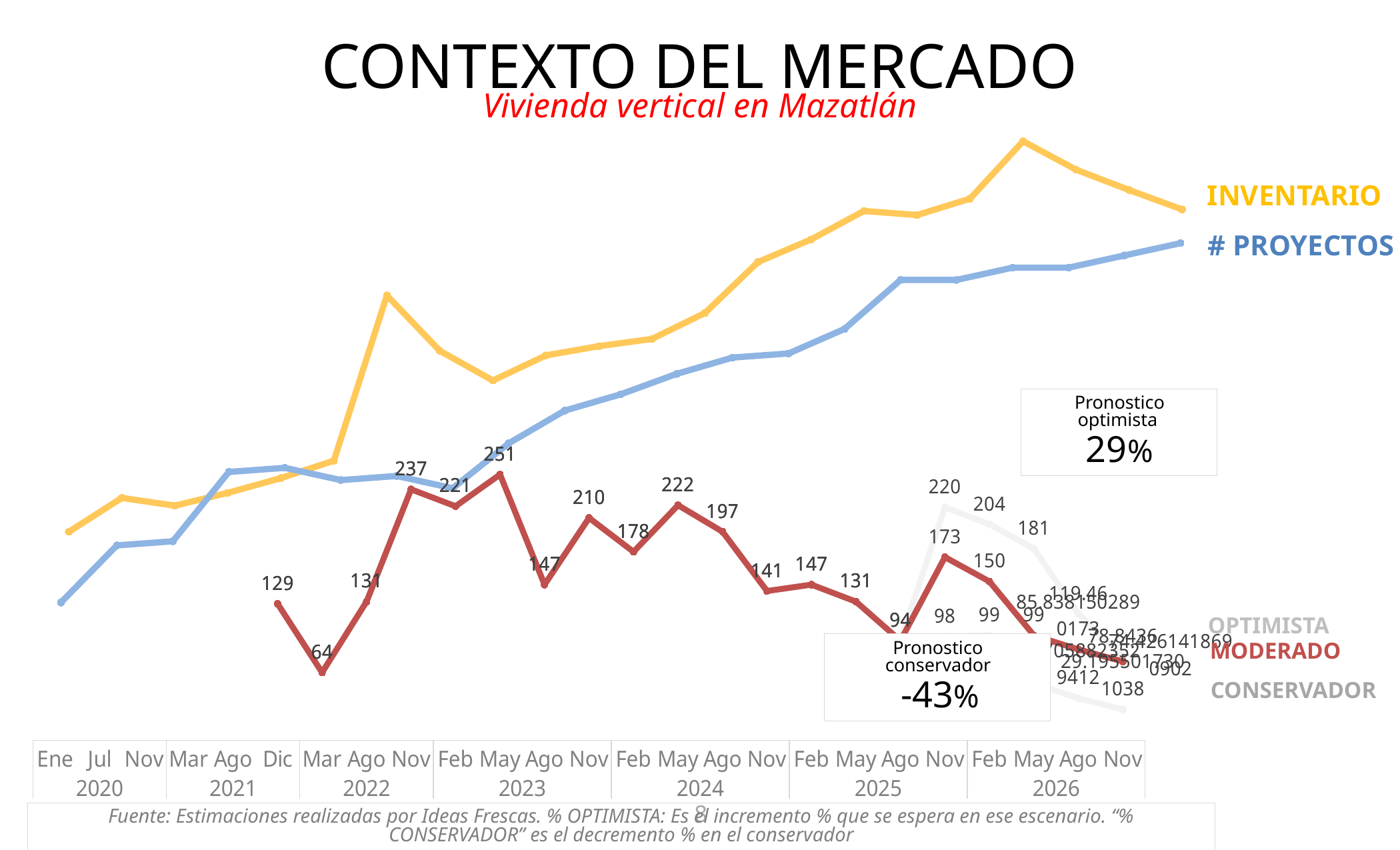
What is the difference between the highest labelled value (251) and the lowest labelled value (64) on the MODERADO line? 187 What kind of chart is shown on the slide? line chart What percentage is shown for the 'Pronostico conservador'? -43% At the right end of the chart (Nov 2026), which line is higher, INVENTARIO or # PROYECTOS? INVENTARIO What is the lowest labelled value on the MODERADO line? 64 Does the # PROYECTOS line generally rise or fall from 2020 to 2026? rise How many years are labelled along the x axis? 7 What is the difference between the MODERADO labelled values 237 and 221? 16 On the MODERADO line, which labelled value is larger, 222 or 210? 222 What percentage is shown for the 'Pronostico optimista'? 29% How many series does the chart's legend list? 5 What is the highest labelled value on the MODERADO line? 251